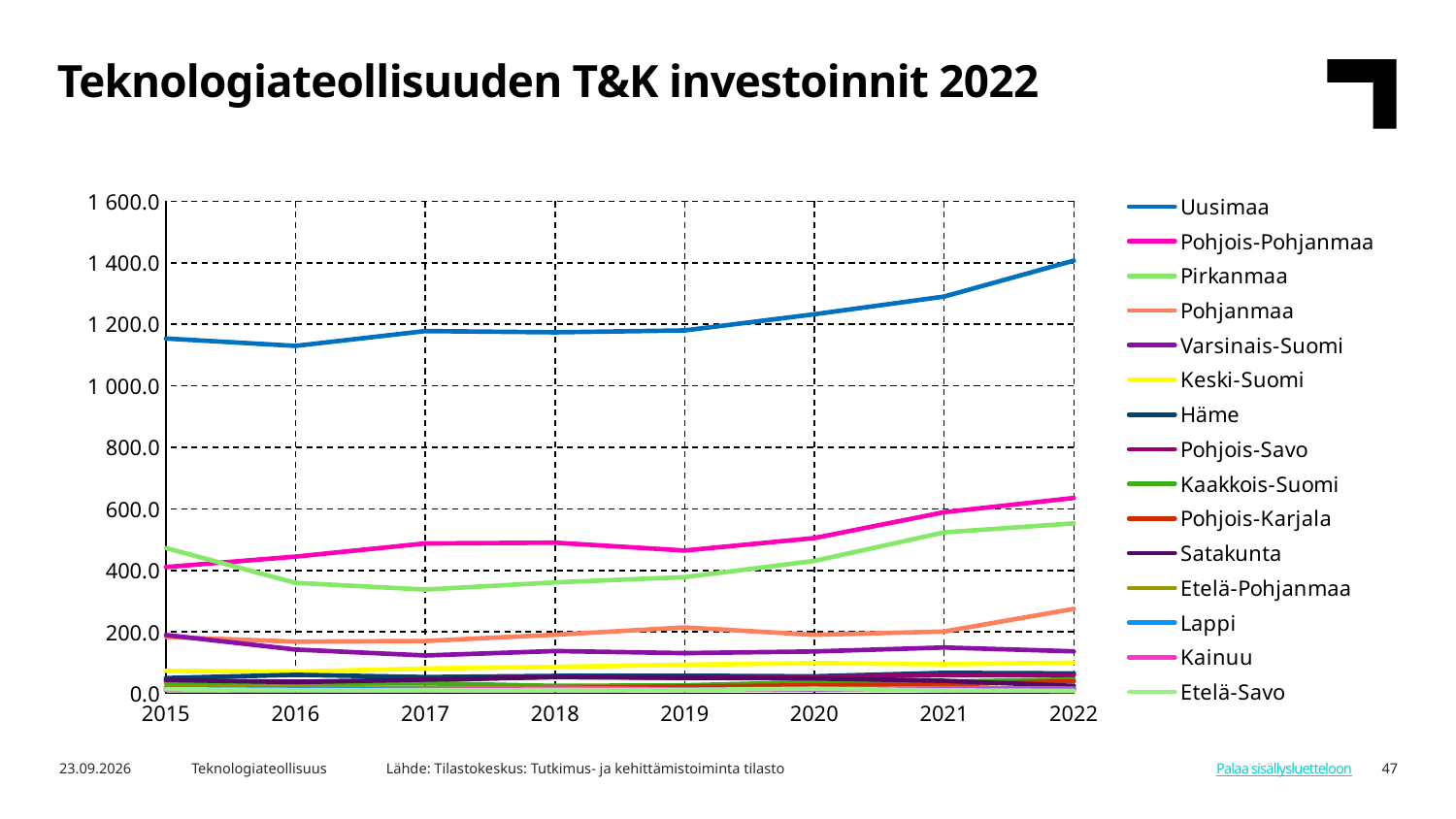
Is the value for Pohjois-Pohjanmaa in 2022 greater or less than 600.0? greater What kind of chart is shown on the slide? line chart In 2015, which is larger: the value for Pirkanmaa or the value for Pohjois-Pohjanmaa? Pirkanmaa How many years are shown on the x axis? 8 Is the value for Uusimaa in 2016 greater or less than 1 200.0? less How many series does the legend list? 15 Is the value for Pirkanmaa in 2017 greater or less than 400.0? less What is the title of the slide? Teknologiateollisuuden T&K investoinnit 2022 Which series has the second highest value in 2022? Pohjois-Pohjanmaa Does the value for Uusimaa rise or fall from 2019 to 2022? rise Which series has the highest value in 2022? Uusimaa